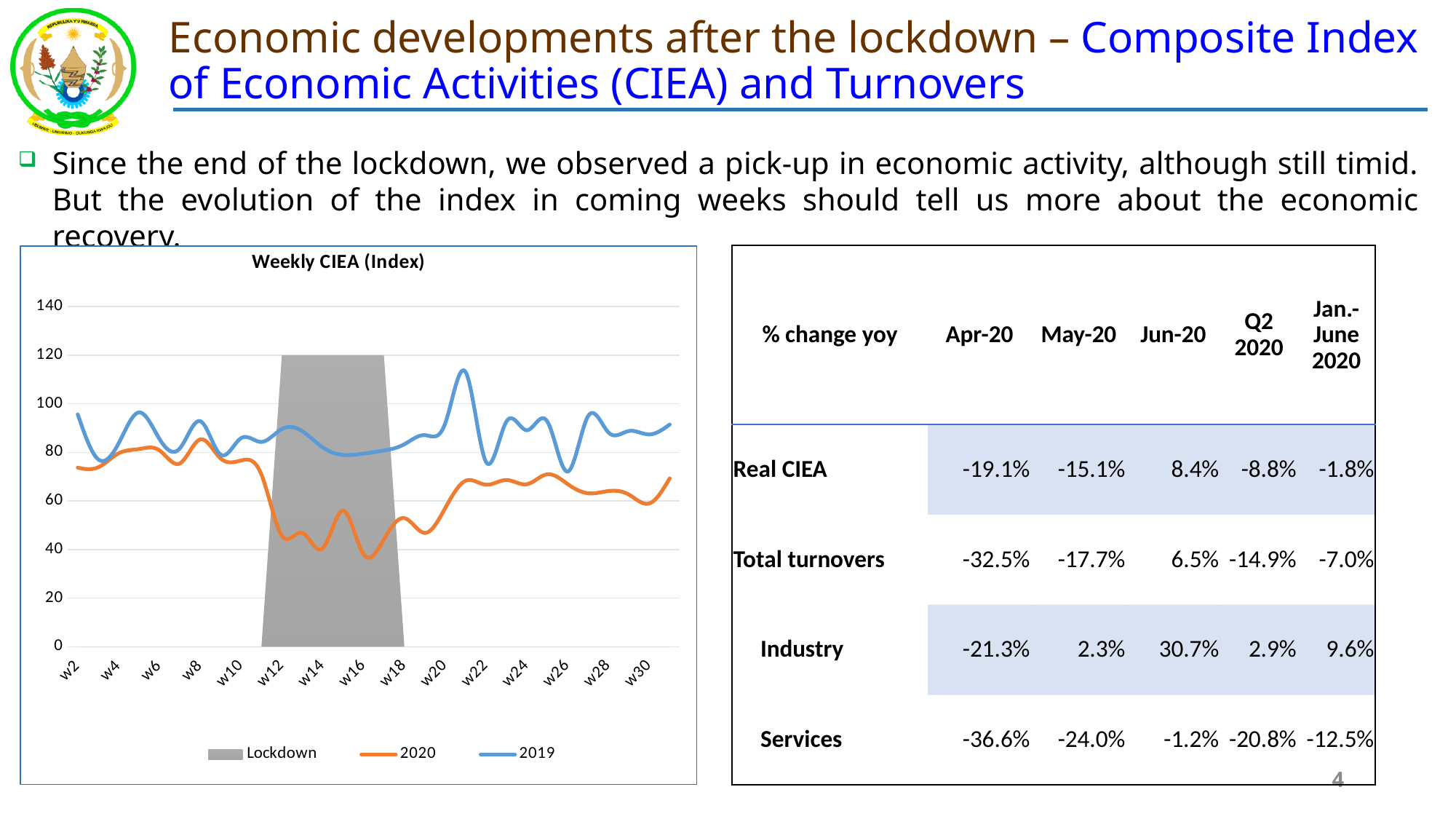
How many week labels are shown on the x axis of the Weekly CIEA chart? 15 What is the title of the chart on the slide? Weekly CIEA (Index) What does the grey shaded area in the Weekly CIEA chart represent? Lockdown What type of chart is the Weekly CIEA (Index) chart? combination area and line chart In the Weekly CIEA chart, is the 2020 value at w30 greater or less than 80? less In the Weekly CIEA chart, is the 2019 value at w2 greater or less than 80? greater In the Weekly CIEA chart, is the 2020 value at w12 greater or less than 60? less In the Weekly CIEA chart, which series is higher at w14, 2019 or 2020? 2019 In the Weekly CIEA chart, which series is higher at w2, 2019 or 2020? 2019 In the Weekly CIEA chart, does the 2020 line rise or fall between w10 and w12? fall How many entries does the legend of the Weekly CIEA (Index) chart list? 3